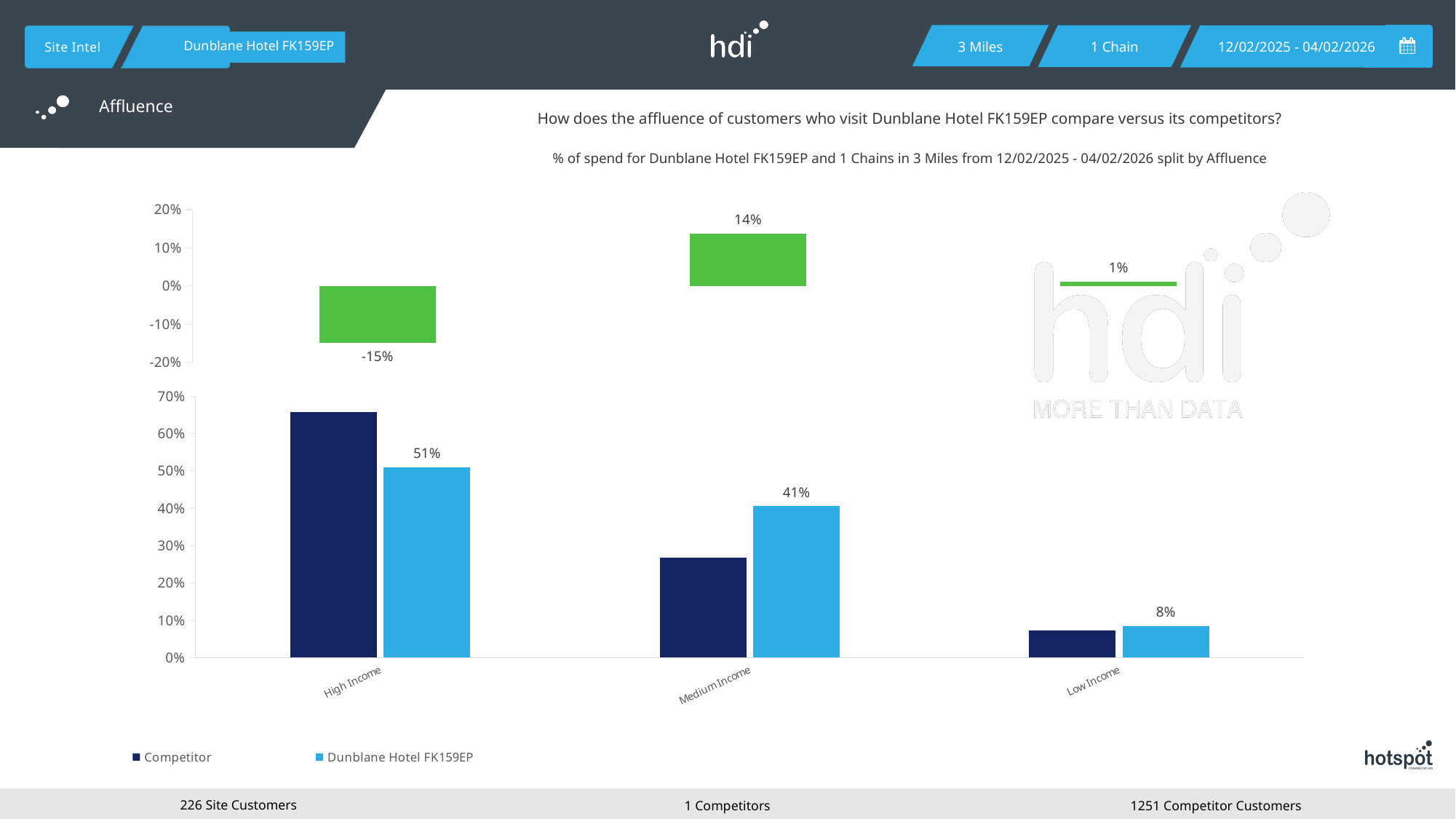
In the bottom chart, what is the difference between the Dunblane Hotel FK159EP values for High Income and Medium Income? 10% In the top chart, what is the value shown for the Medium Income category? 14% In the bottom chart, what is the value for Dunblane Hotel FK159EP in the Medium Income category? 41% In the bottom chart, what is the value for Dunblane Hotel FK159EP in the Low Income category? 8% In the bottom chart, which is larger for Medium Income: Competitor or Dunblane Hotel FK159EP? Dunblane Hotel FK159EP In the bottom chart, is the Competitor value for Medium Income greater or less than 30%? less In the bottom chart, is the Competitor value for High Income greater or less than 60%? greater In the top chart, what is the value shown for the High Income category? -15% In the bottom chart, which category has the highest value for Dunblane Hotel FK159EP? High Income In the top chart, which category has the lowest value? High Income How many series does the legend of the bottom chart list? 2 In the bottom chart, what is the value for Dunblane Hotel FK159EP in the High Income category? 51%